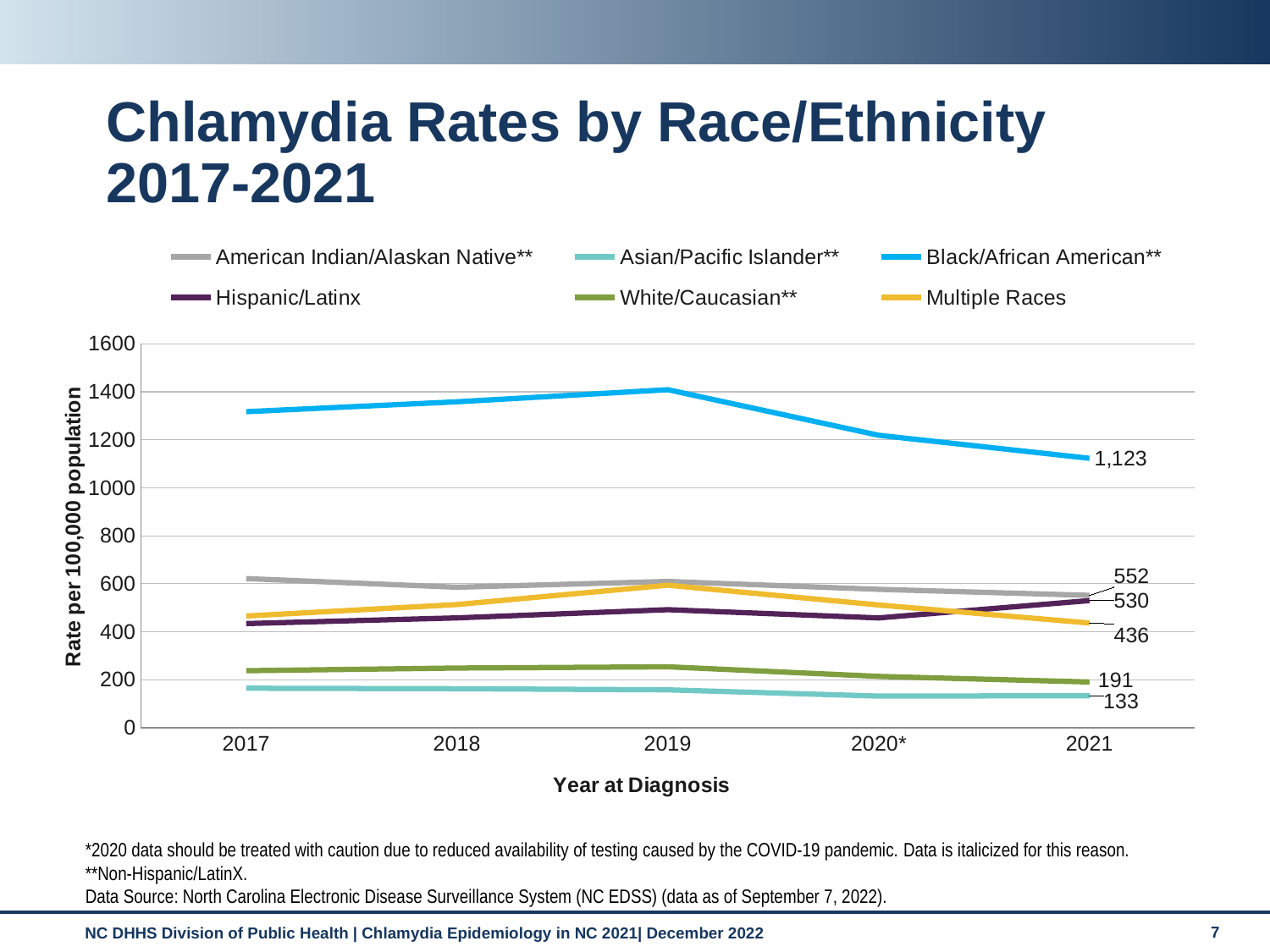
What type of chart is shown on the slide? line chart What is the chlamydia rate for Asian/Pacific Islander in 2021? 133 Which race/ethnicity has the highest rate in 2021? Black/African American What is the difference between the 2021 rates for Black/African American and Asian/Pacific Islander? 990 What is the label of the y axis? Rate per 100,000 population Which race/ethnicity has the lowest rate in 2021? Asian/Pacific Islander What is the chlamydia rate for Black/African American in 2021? 1,123 How many years are shown along the x axis? 5 Is the rate for Black/African American in 2017 greater or less than 1200? greater What is the chlamydia rate for White/Caucasian in 2021? 191 How many series does the legend list? 6 Does the rate for Black/African American rise or fall from 2019 to 2021? fall